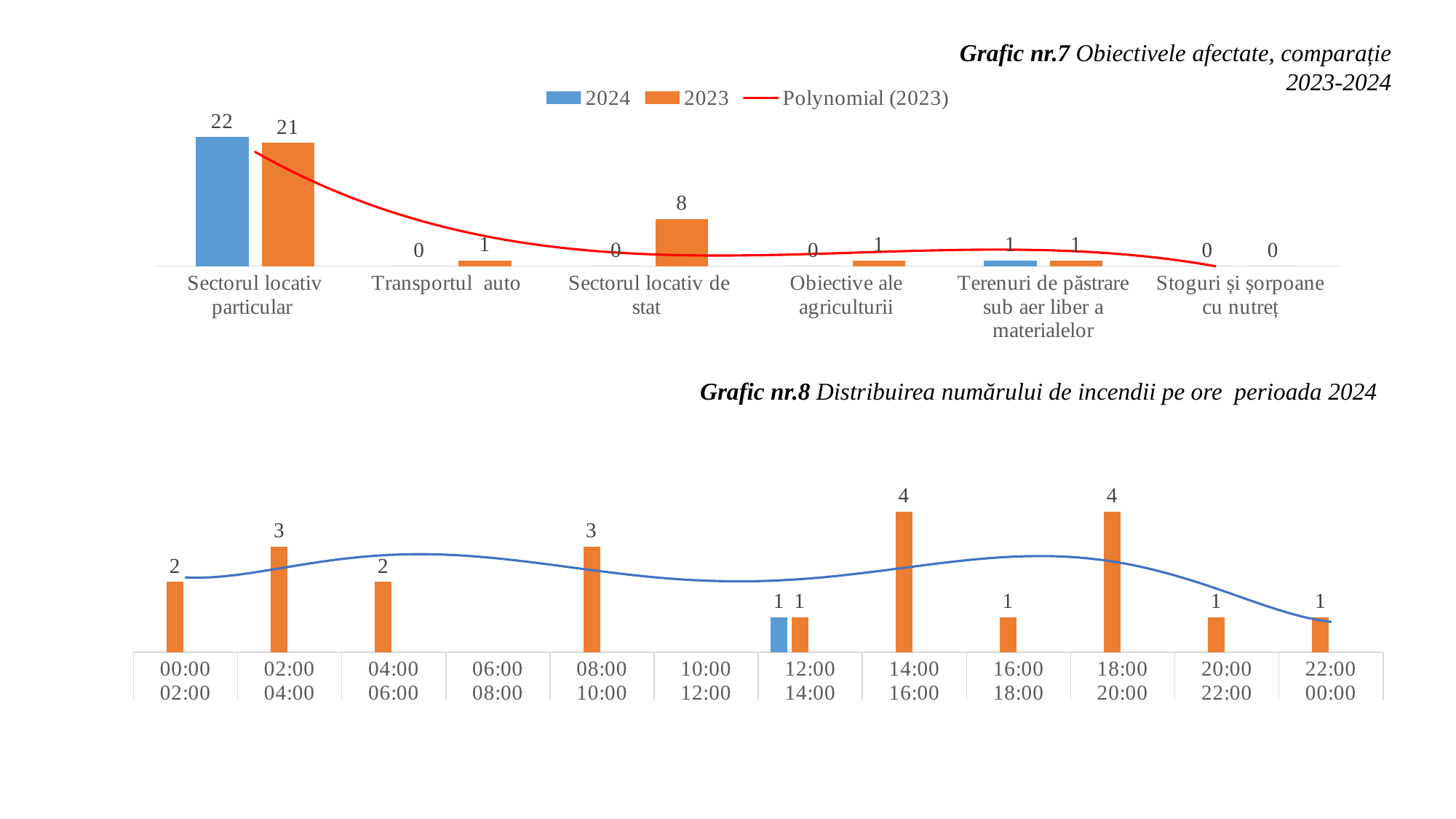
In Grafic nr.7, what is the 2024 value for Sectorul locativ particular? 22 In Grafic nr.8, what is the value for the 02:00–04:00 interval? 3 In Grafic nr.7, what is the 2023 value for Sectorul locativ de stat? 8 In Grafic nr.7, which is larger for Sectorul locativ particular: the 2024 value or the 2023 value? 2024 What kind of chart is Grafic nr.8? Bar chart In Grafic nr.8, what is the value for the 14:00–16:00 interval? 4 In Grafic nr.7, how many entries does the legend list? 3 In Grafic nr.8, how many time intervals are shown on the x axis? 12 In Grafic nr.7, which category has the highest 2023 value? Sectorul locativ particular In Grafic nr.7, what is the 2023 value for Sectorul locativ particular? 21 In Grafic nr.7, how many categories are shown on the x axis? 6 In Grafic nr.7, what is the difference between the 2023 values for Sectorul locativ particular and Sectorul locativ de stat? 13